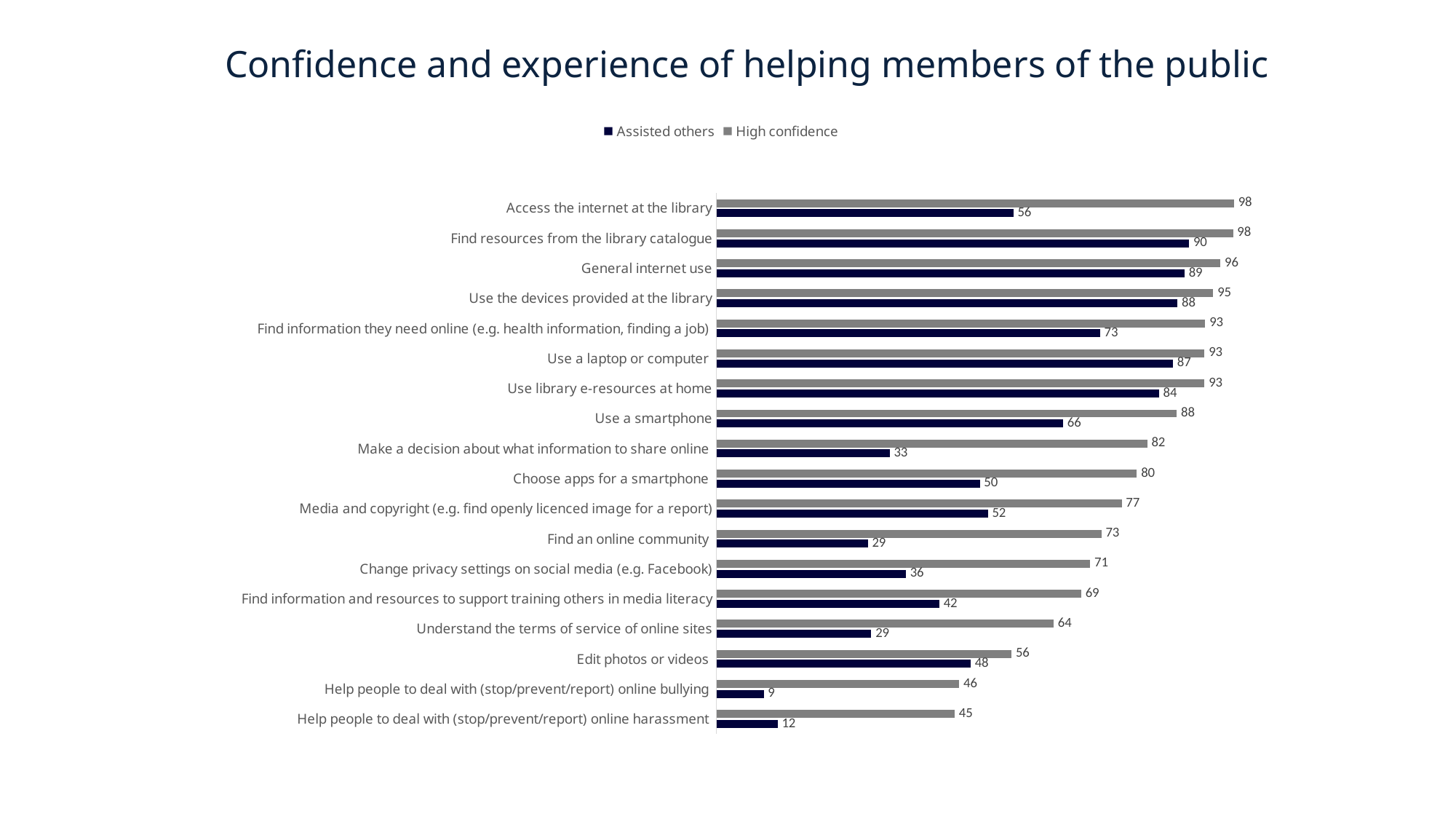
What is the title of the chart? Confidence and experience of helping members of the public Which category has the highest 'Assisted others' value? Find resources from the library catalogue How many categories are shown in the chart? 18 What is the difference between the 'High confidence' and 'Assisted others' values for 'Edit photos or videos'? 8 Which category has the lowest 'Assisted others' value? Help people to deal with (stop/prevent/report) online bullying What is the 'High confidence' value for 'Use a smartphone'? 88 What is the 'Assisted others' value for 'Find an online community'? 29 How many series does the legend list? 2 What kind of chart is shown on the slide? Bar chart Which is larger: the 'Assisted others' value for 'Use a laptop or computer' or for 'Use library e-resources at home'? Use a laptop or computer What is the 'Assisted others' value for 'Access the internet at the library'? 56 What is the difference between the 'High confidence' and 'Assisted others' values for 'Make a decision about what information to share online'? 49